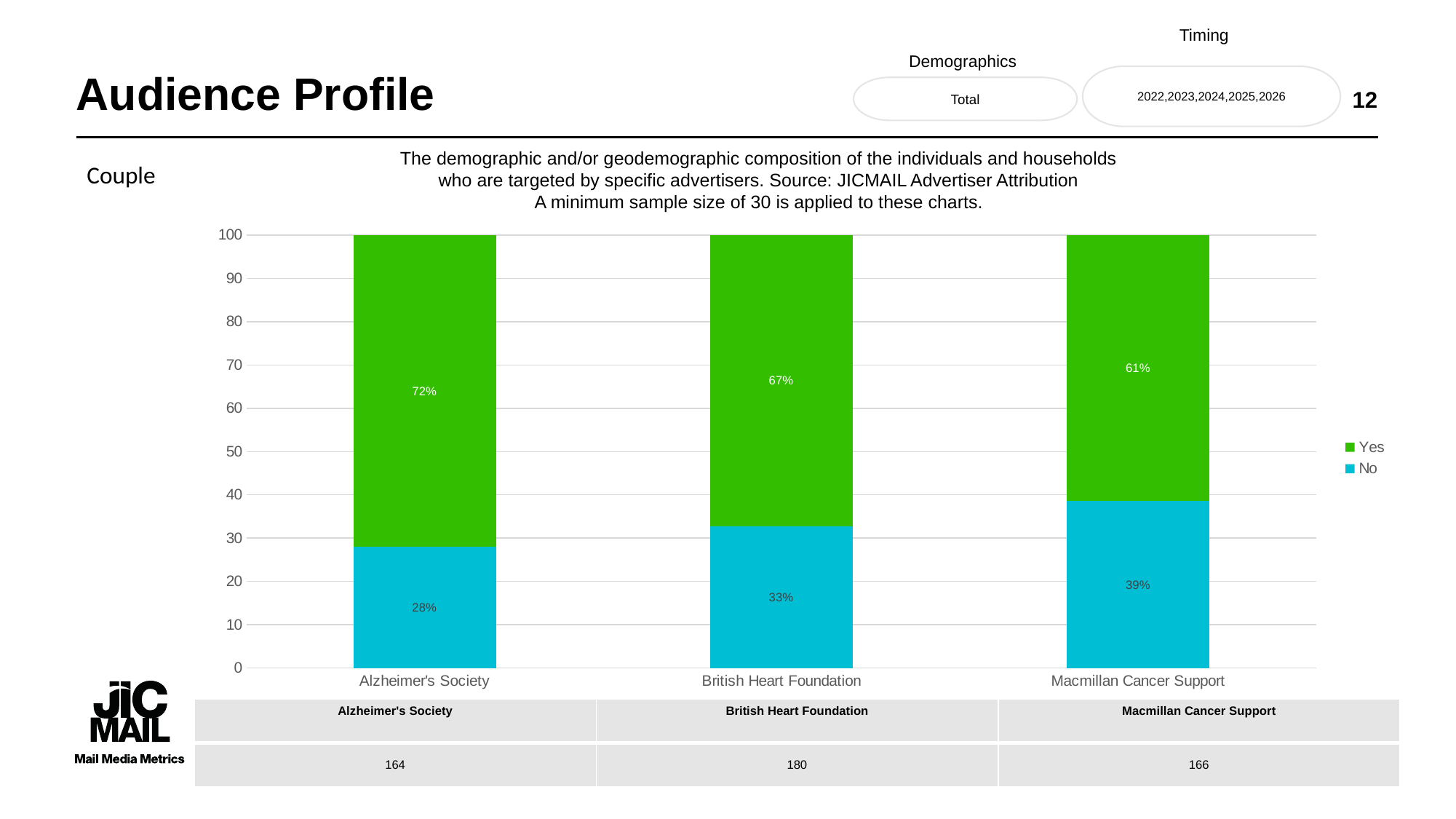
How many series does the legend list? 2 Which category has the lowest 'No' value? Alzheimer's Society What is the difference between the 'Yes' values for Alzheimer's Society and Macmillan Cancer Support? 11% How many categories are shown on the x axis? 3 Which category has the highest 'Yes' value? Alzheimer's Society What kind of chart is shown on the slide? Stacked bar chart Is the 'No' value larger for British Heart Foundation or for Macmillan Cancer Support? Macmillan Cancer Support What is the 'Yes' value for Alzheimer's Society? 72% What is the 'No' value for British Heart Foundation? 33% Which colour represents the 'Yes' series in the legend? Green What is the 'Yes' value for Macmillan Cancer Support? 61% What is the 'No' value for Macmillan Cancer Support? 39%